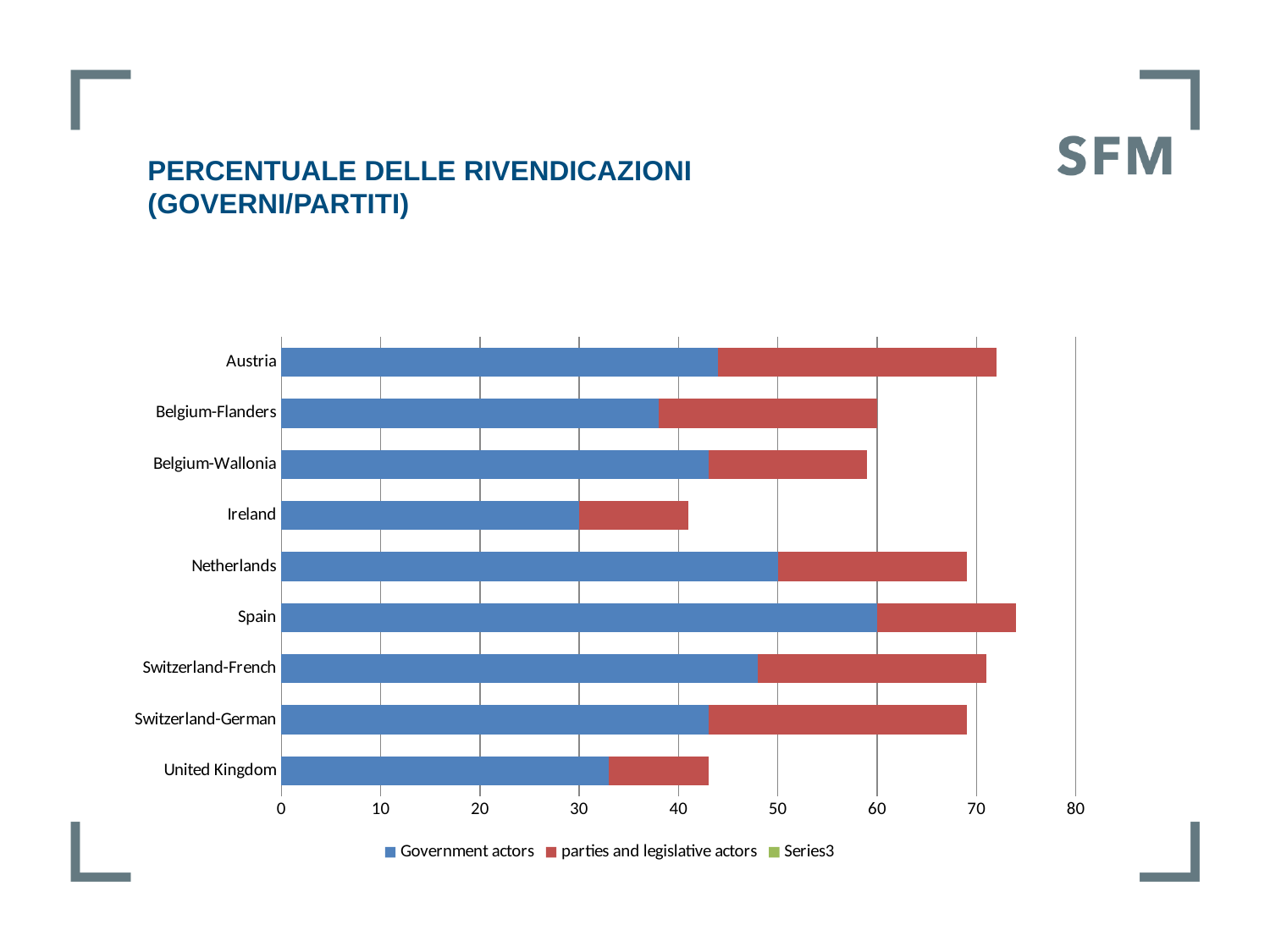
How many series does the legend list? 3 Which has a larger Government actors value, Netherlands or Belgium-Flanders? Netherlands Which has a longer total bar, Austria or United Kingdom? Austria How many countries or regions are listed on the chart? 9 What colour represents Government actors in the chart? blue What is the second legend entry in the chart? parties and legislative actors Which country or region has the highest value for Government actors? Spain What kind of chart is shown on the slide? bar chart Is the Government actors value for Spain greater or less than 50? greater Is the Government actors value for Ireland greater or less than 40? less Is the total length of the Netherlands bar greater or less than 60? greater